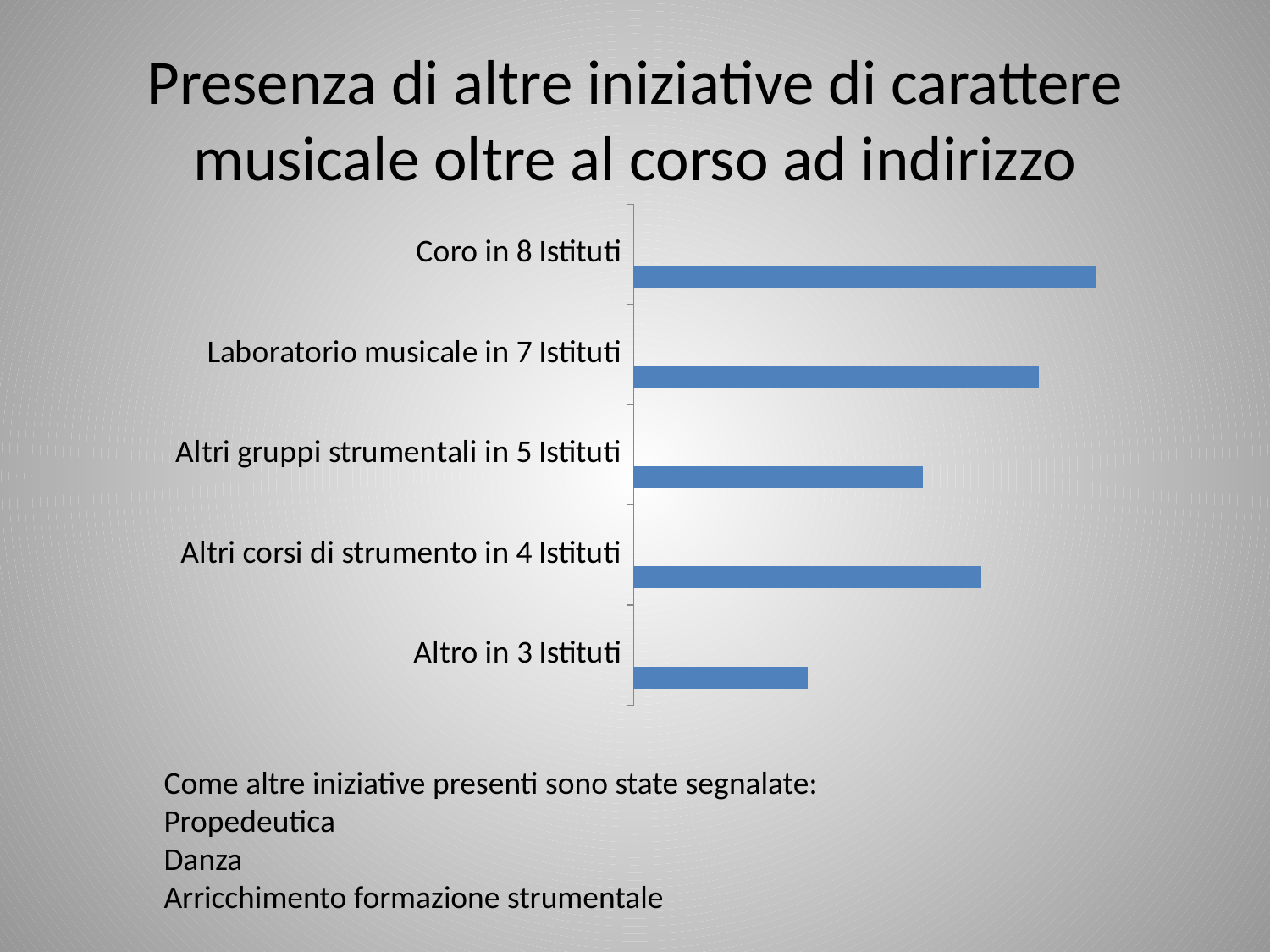
Which bar is longer: 'Coro in 8 Istituti' or 'Laboratorio musicale in 7 Istituti'? Coro in 8 Istituti Which category has the shortest bar? Altro in 3 Istituti Which bar is longer: 'Altri gruppi strumentali in 5 Istituti' or 'Altri corsi di strumento in 4 Istituti'? Altri corsi di strumento in 4 Istituti How many categories does the chart show? 5 What is the title of the slide containing the chart? Presenza di altre iniziative di carattere musicale oltre al corso ad indirizzo Which category is listed at the top of the chart? Coro in 8 Istituti Which bar is shorter: 'Altro in 3 Istituti' or 'Altri gruppi strumentali in 5 Istituti'? Altro in 3 Istituti Which category has the longest bar? Coro in 8 Istituti What kind of chart is shown on the slide? bar chart